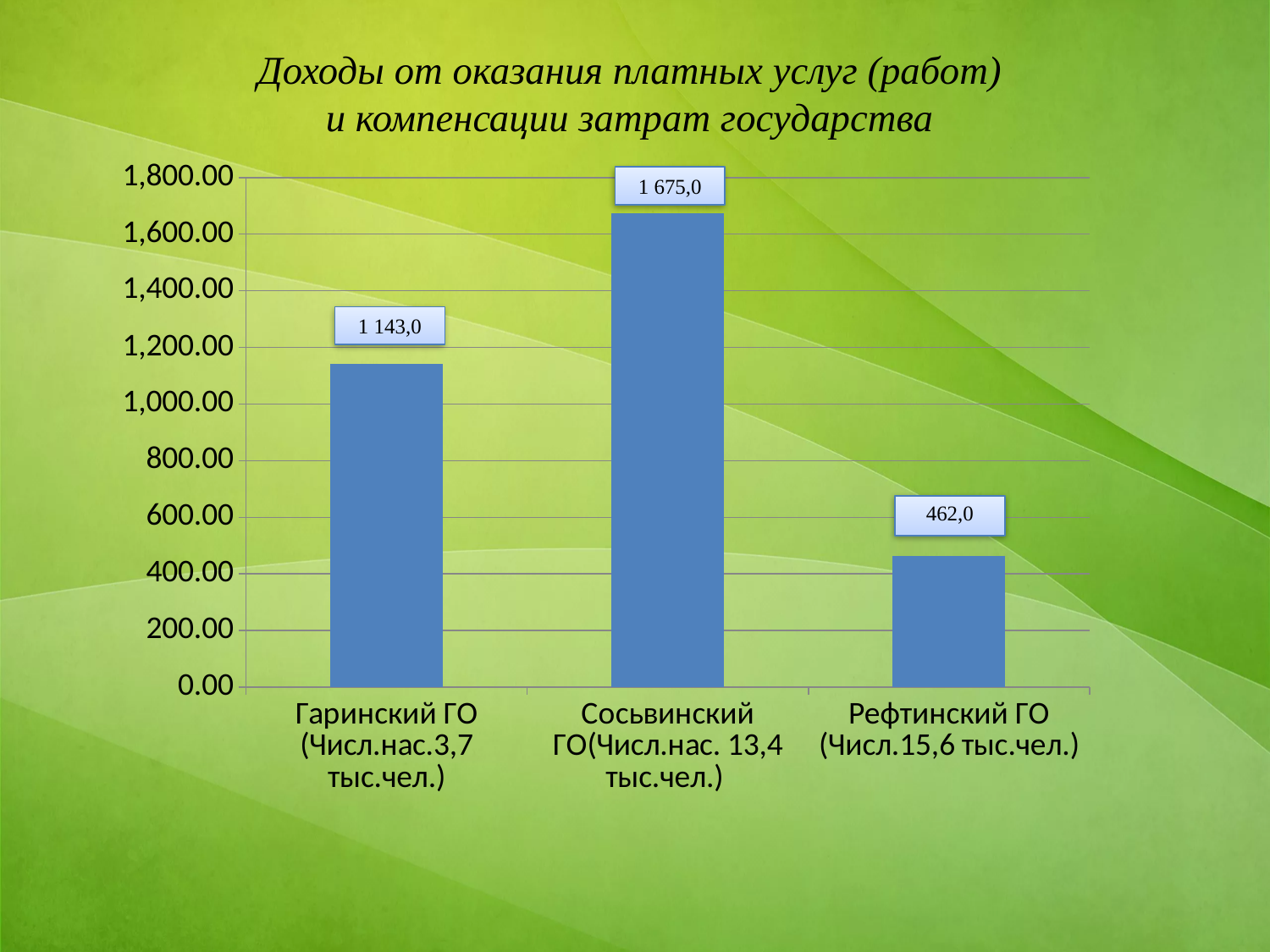
Which is larger, the value for Гаринский ГО or the value for Рефтинский ГО? Гаринский ГО What is the value for Гаринский ГО? 1 143,0 Is the value for Рефтинский ГО greater or less than 600.00? less What is the value for Сосьвинский ГО? 1 675,0 What is the difference between the values for Сосьвинский ГО and Гаринский ГО? 532,0 Which category has the highest value? Сосьвинский ГО What is the difference between the values for Гаринский ГО and Рефтинский ГО? 681,0 What is the value for Рефтинский ГО? 462,0 How many categories are shown in the chart? 3 Which category has the lowest value? Рефтинский ГО What is the title of the chart? Доходы от оказания платных услуг (работ) и компенсации затрат государства What kind of chart is shown on the slide? bar chart